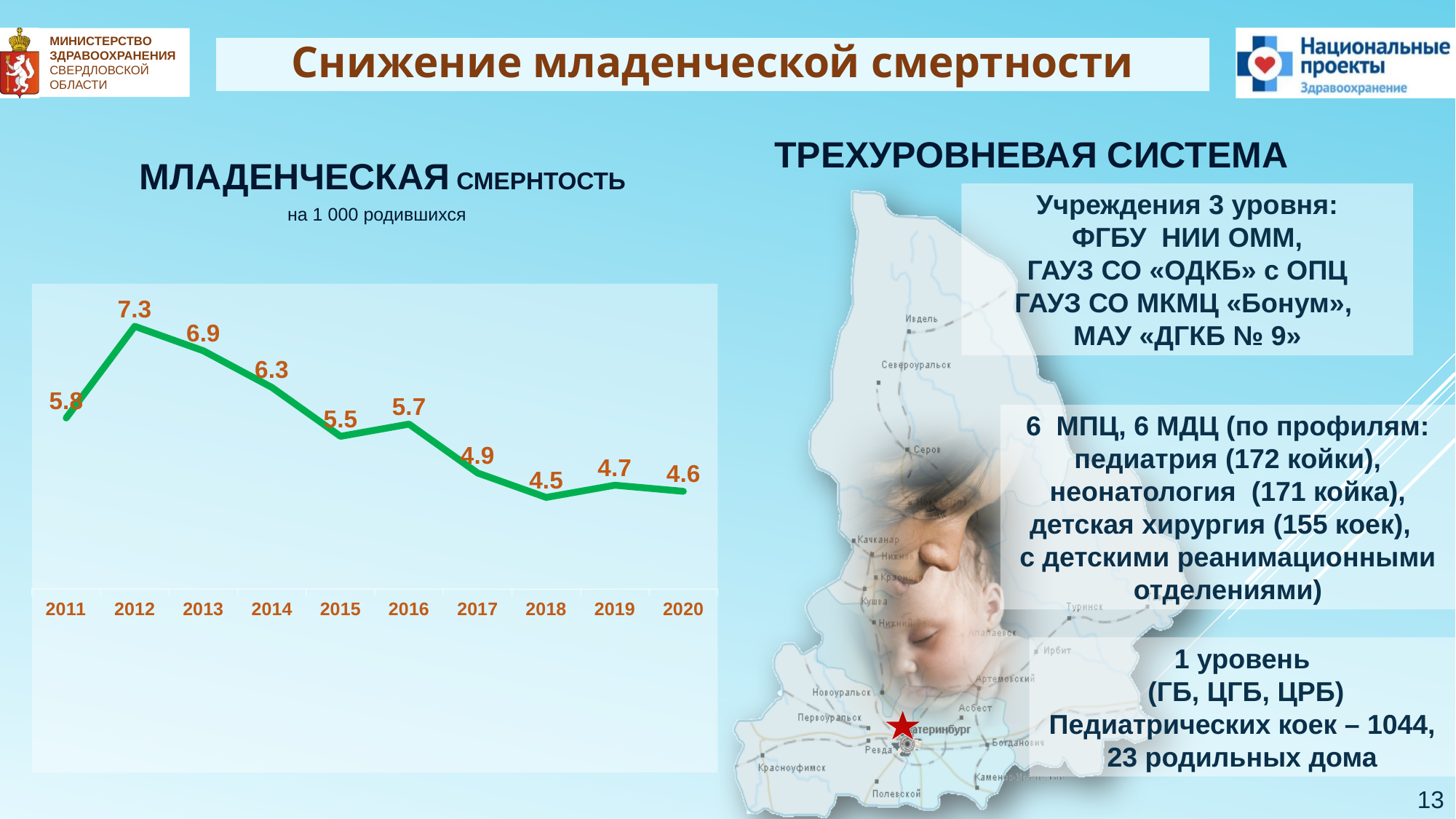
What was the infant mortality rate in 2020? 4.6 Which year had a higher infant mortality rate, 2015 or 2016? 2016 What was the infant mortality rate in 2016? 5.7 Which year had the lowest infant mortality rate? 2018 What type of chart is shown on the slide? Line chart What unit is the infant mortality rate expressed in, according to the chart subtitle? на 1 000 родившихся What is the difference between the infant mortality rate in 2011 and in 2018? 1.3 What was the infant mortality rate in 2012? 7.3 What is the overall trend of the infant mortality rate from 2012 to 2020? Falling By how much did the infant mortality rate fall from 2012 to 2020? 2.7 How many years are plotted on the chart? 10 Which year had the highest infant mortality rate? 2012